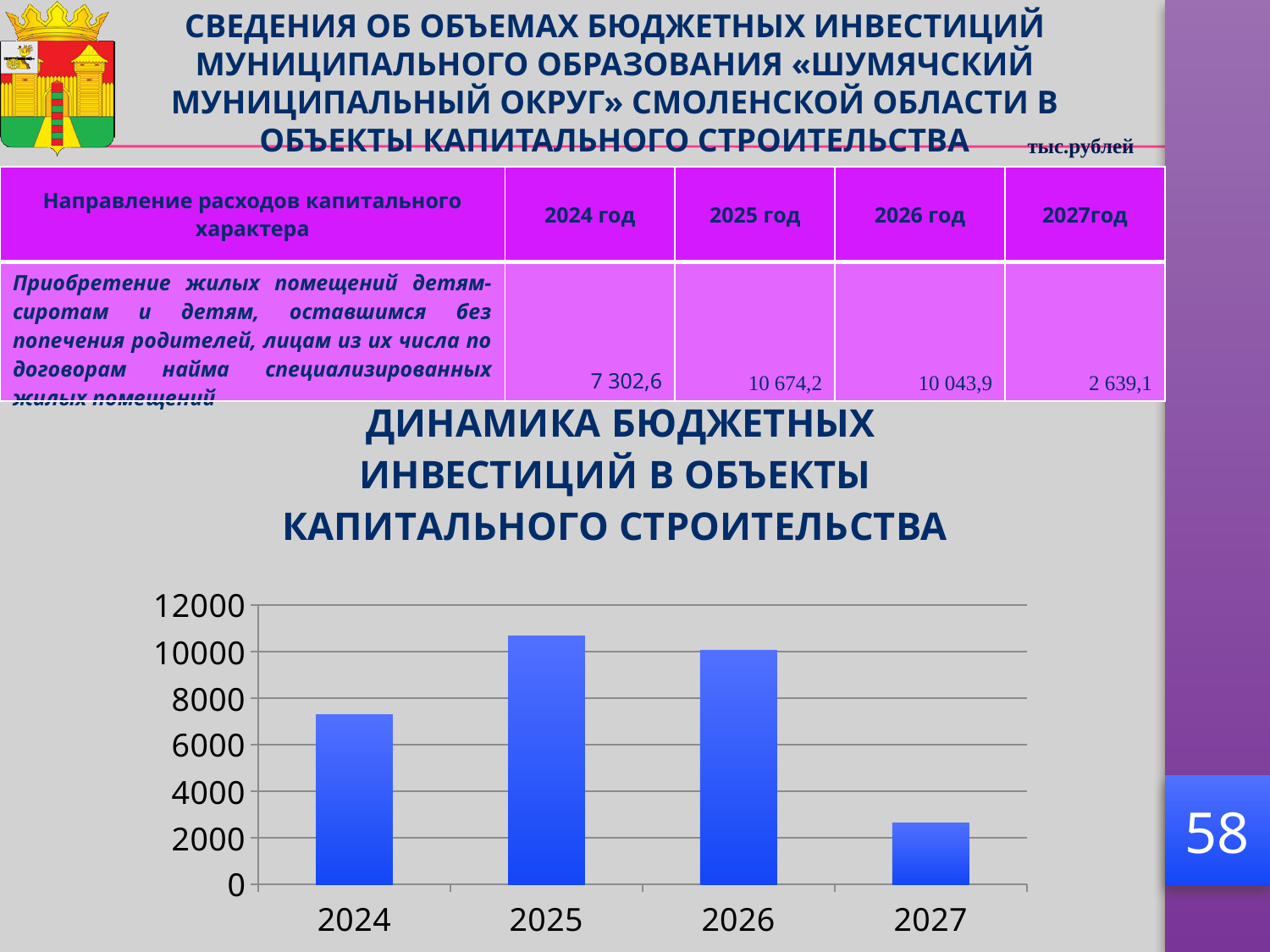
Which year has the highest bar on the chart? 2025 Is the value for 2027 greater or less than 4000? less What kind of chart is shown on the slide? bar chart How many years (bars) are shown on the chart? 4 According to the table on the slide, what is the value for 2025 (thousand rubles)? 10 674,2 Is the value for 2026 greater or less than 8000? greater Is the value for 2024 greater or less than 8000? less Do the values rise or fall from 2025 to 2027 on the chart? fall Which is larger, the value for 2024 or the value for 2026? 2026 Which year has the lowest bar on the chart? 2027 According to the table on the slide, what is the value for 2027 (thousand rubles)? 2 639,1